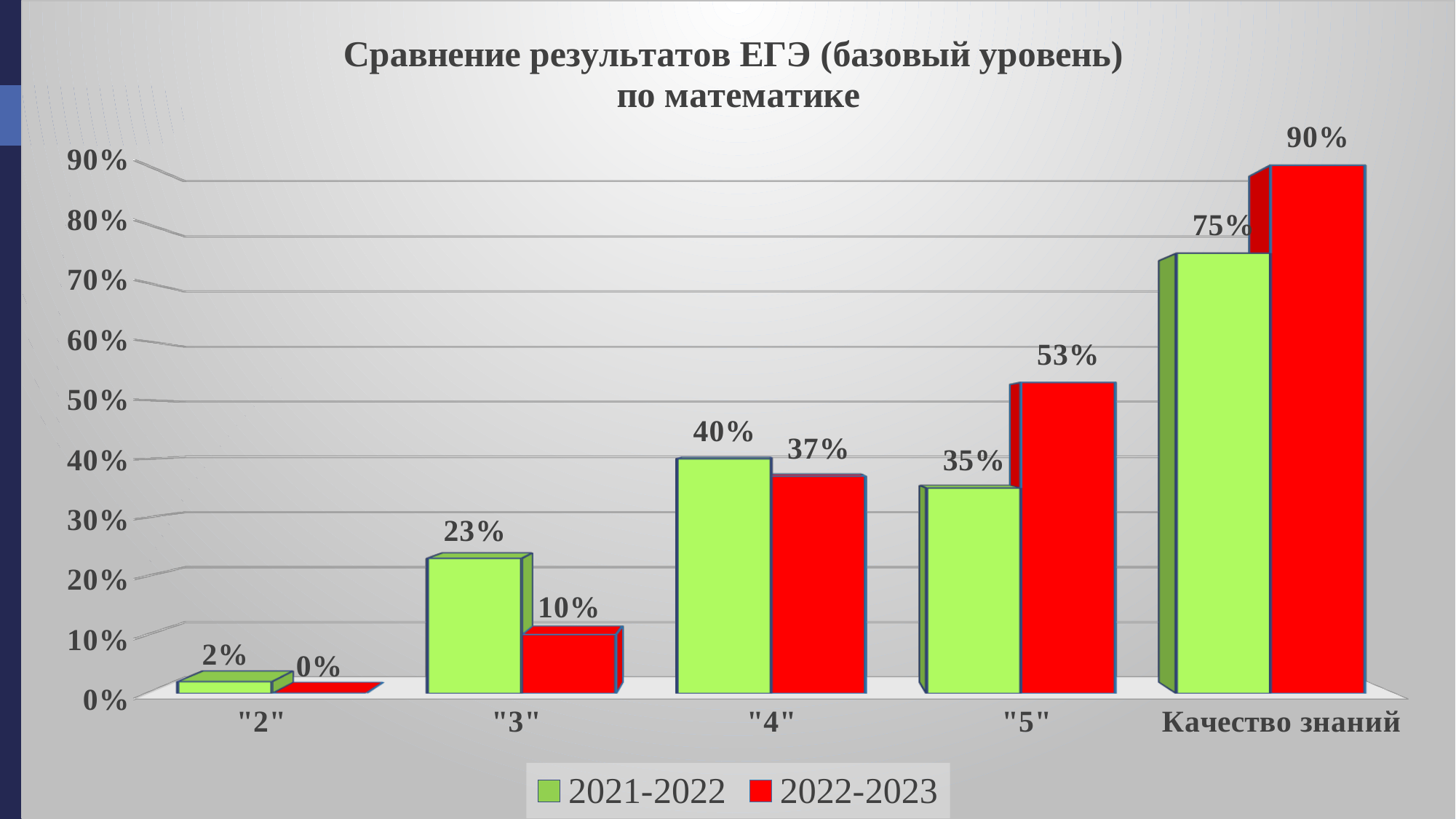
What kind of chart is shown on the slide? bar chart What is the difference between the 2021-2022 and 2022-2023 values for "3"? 13% Which is larger for "4": the 2021-2022 value or the 2022-2023 value? 2021-2022 What is the value for "5" in the 2022-2023 series? 53% What is the value for "3" in the 2021-2022 series? 23% Which colour represents the 2022-2023 series? red Which category has the lowest value in the 2022-2023 series? "2" Which category has the highest value in the 2021-2022 series? Качество знаний How many categories are shown on the x axis? 5 What is the value for Качество знаний in the 2022-2023 series? 90% What is the difference between the 2022-2023 and 2021-2022 values for Качество знаний? 15% How many series does the legend list? 2